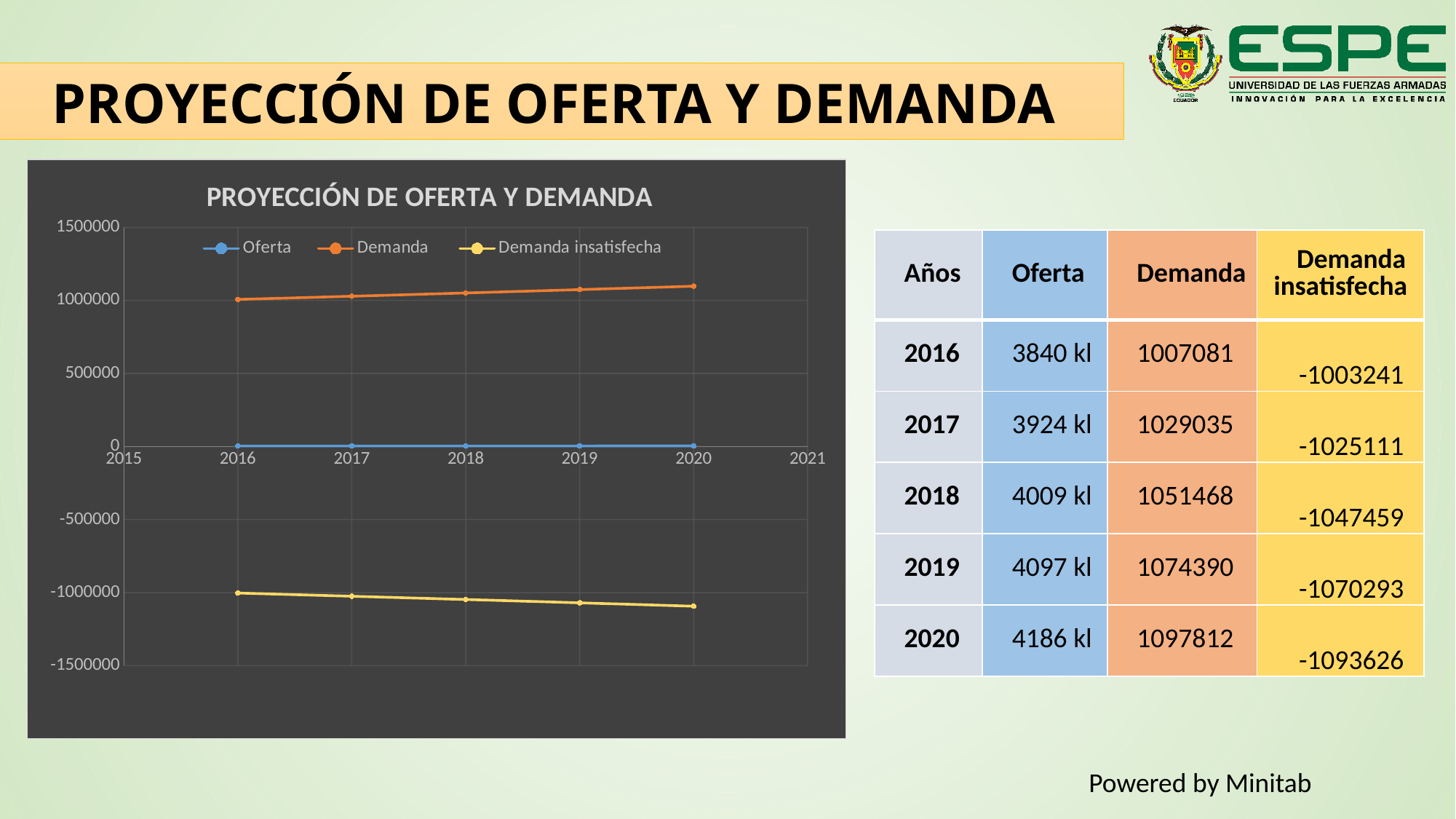
How many years are plotted on the chart? 5 In 2018, which is larger, Demanda or Oferta? Demanda How many series does the chart legend list? 3 Is the Demanda value for 2020 greater or less than 1000000? greater What is the Demanda value for 2020? 1097812 What kind of chart is shown on the slide? line chart Does the Demanda insatisfecha line rise or fall from 2016 to 2020? fall What is the title of the chart? PROYECCIÓN DE OFERTA Y DEMANDA Which year has the highest Demanda value? 2020 Does the Demanda line rise or fall from 2016 to 2020? rise What is the Oferta value for 2016? 3840 kl Is the Demanda insatisfecha value for 2016 greater or less than -500000? less